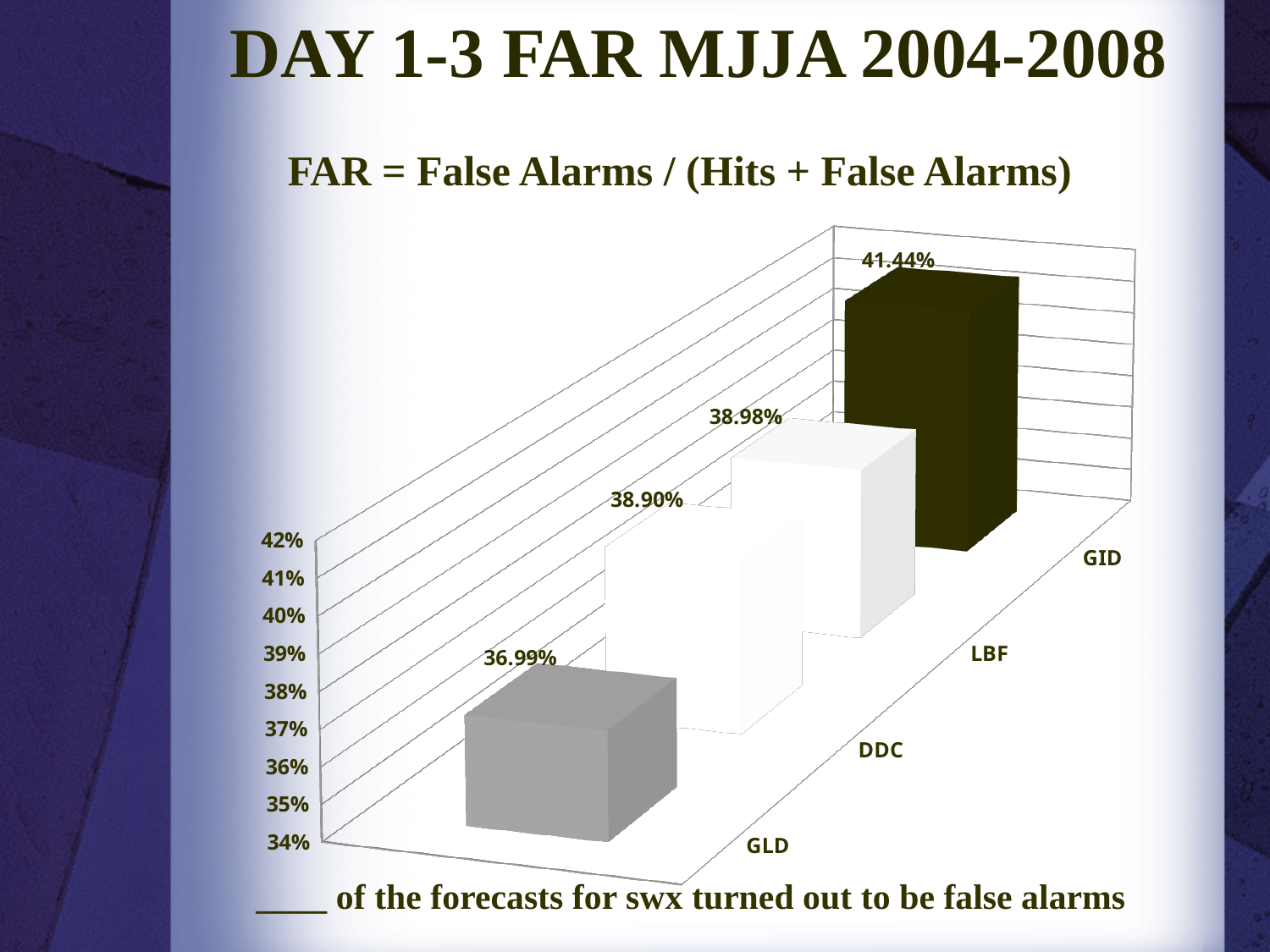
Which category has the lowest FAR? GLD What is the difference between the FAR for GID and the FAR for GLD? 4.45% What is the FAR value for GLD? 36.99% Is the FAR value for GLD greater or less than 38%? less Which category has the highest FAR? GID What is the FAR value for DDC? 38.90% What is the FAR value for LBF? 38.98% What kind of chart is shown on the slide? bar chart What is the difference between the FAR for LBF and the FAR for DDC? 0.08% How many categories are shown in the chart? 4 What is the FAR value for GID? 41.44% Which has a larger FAR, GID or DDC? GID